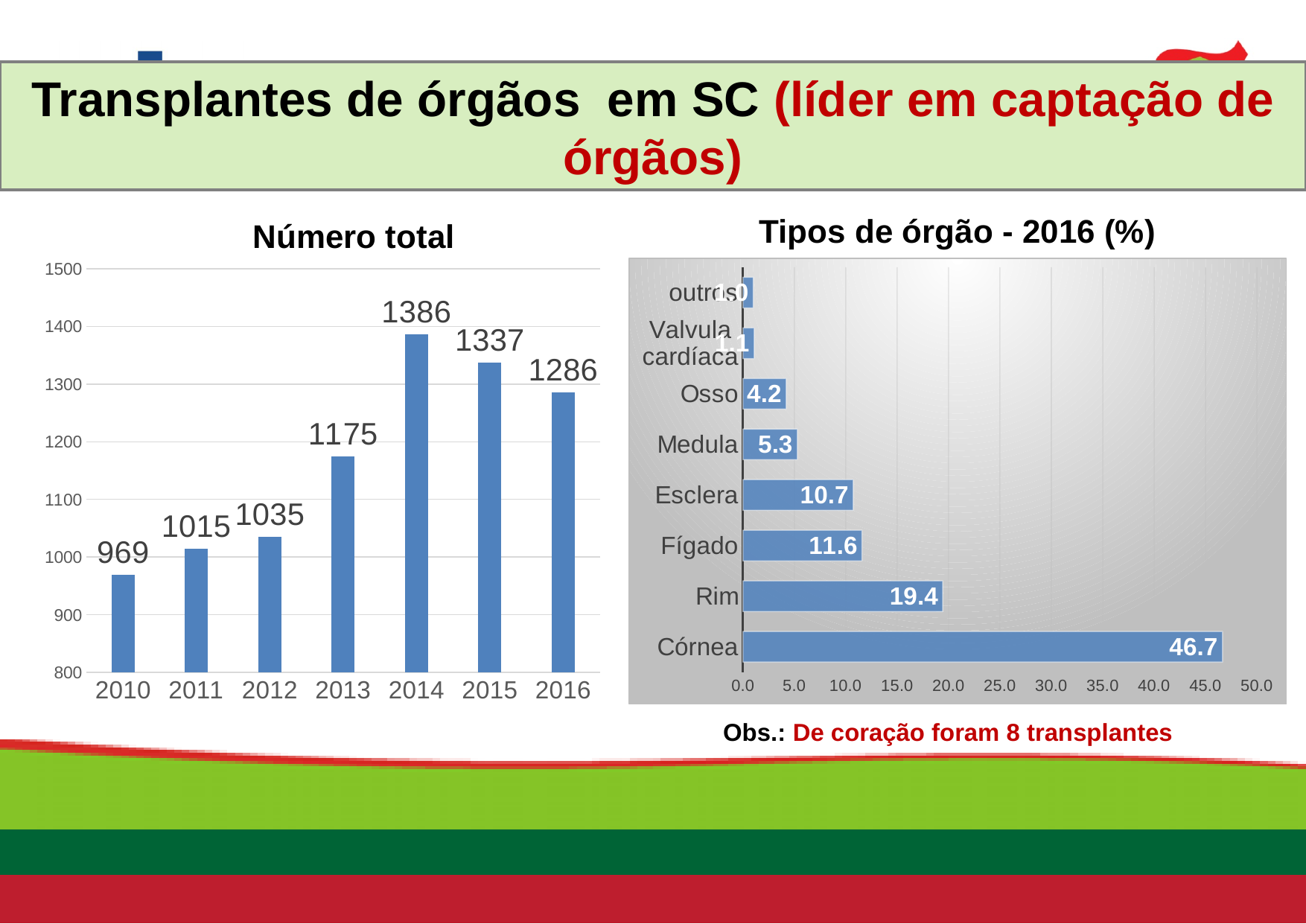
In the 'Tipos de órgão - 2016 (%)' chart, what is the value for Córnea? 46.7 In the 'Tipos de órgão - 2016 (%)' chart, what is the difference between the values for Rim and Fígado? 7.8 In the 'Número total' chart, which year has the lowest value? 2010 In the 'Número total' chart, what is the difference between the values for 2014 and 2016? 100 What kind of chart is the 'Tipos de órgão - 2016 (%)' chart? bar chart In the 'Número total' chart, which year has the highest value? 2014 In the 'Tipos de órgão - 2016 (%)' chart, which is larger, Fígado or Esclera? Fígado In the 'Tipos de órgão - 2016 (%)' chart, what is the value for Rim? 19.4 In the 'Número total' chart, how many years are shown on the x axis? 7 In the 'Número total' chart, do the values rise or fall from 2010 to 2014? rise In the 'Número total' chart, what is the value for 2010? 969 In the 'Número total' chart, what is the value for 2014? 1386